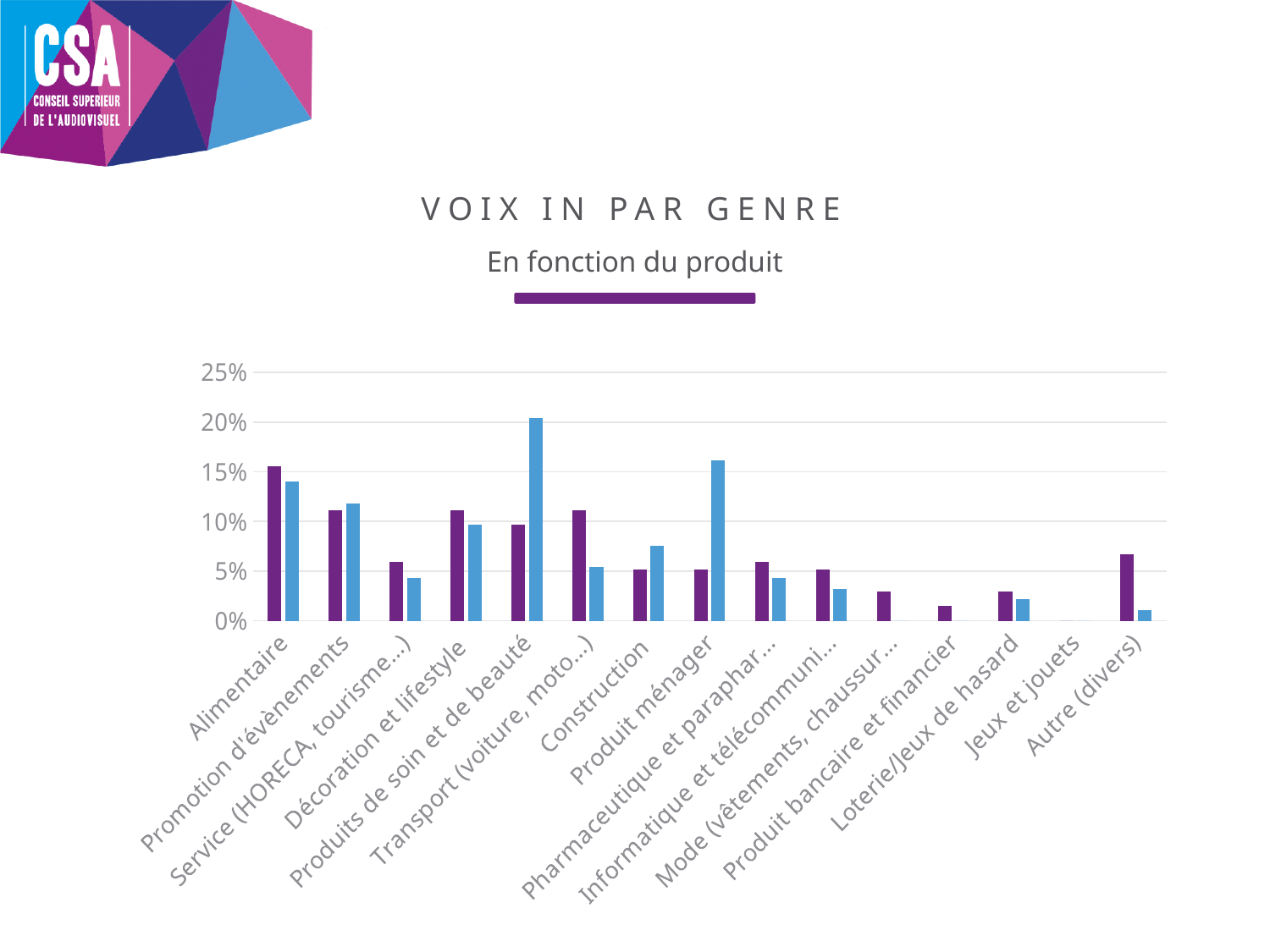
Which product category has the tallest bar in the chart? Produits de soin et de beauté What kind of chart is shown on the slide? bar chart For Construction, which bar is taller, the purple one or the blue one? the blue one How many bars are plotted for each product category? 2 For Produits de soin et de beauté, which bar is taller, the purple one or the blue one? the blue one Which product category has the tallest purple bar? Alimentaire Is the blue bar for Produits de soin et de beauté greater or less than 15%? greater Is the blue bar for Produit ménager greater or less than 10%? greater Is the purple bar for Mode (vêtements, chaussur...) greater or less than 5%? less What is the subtitle shown under the chart title 'VOIX IN PAR GENRE'? En fonction du produit How many product categories are shown on the x axis of the chart? 15